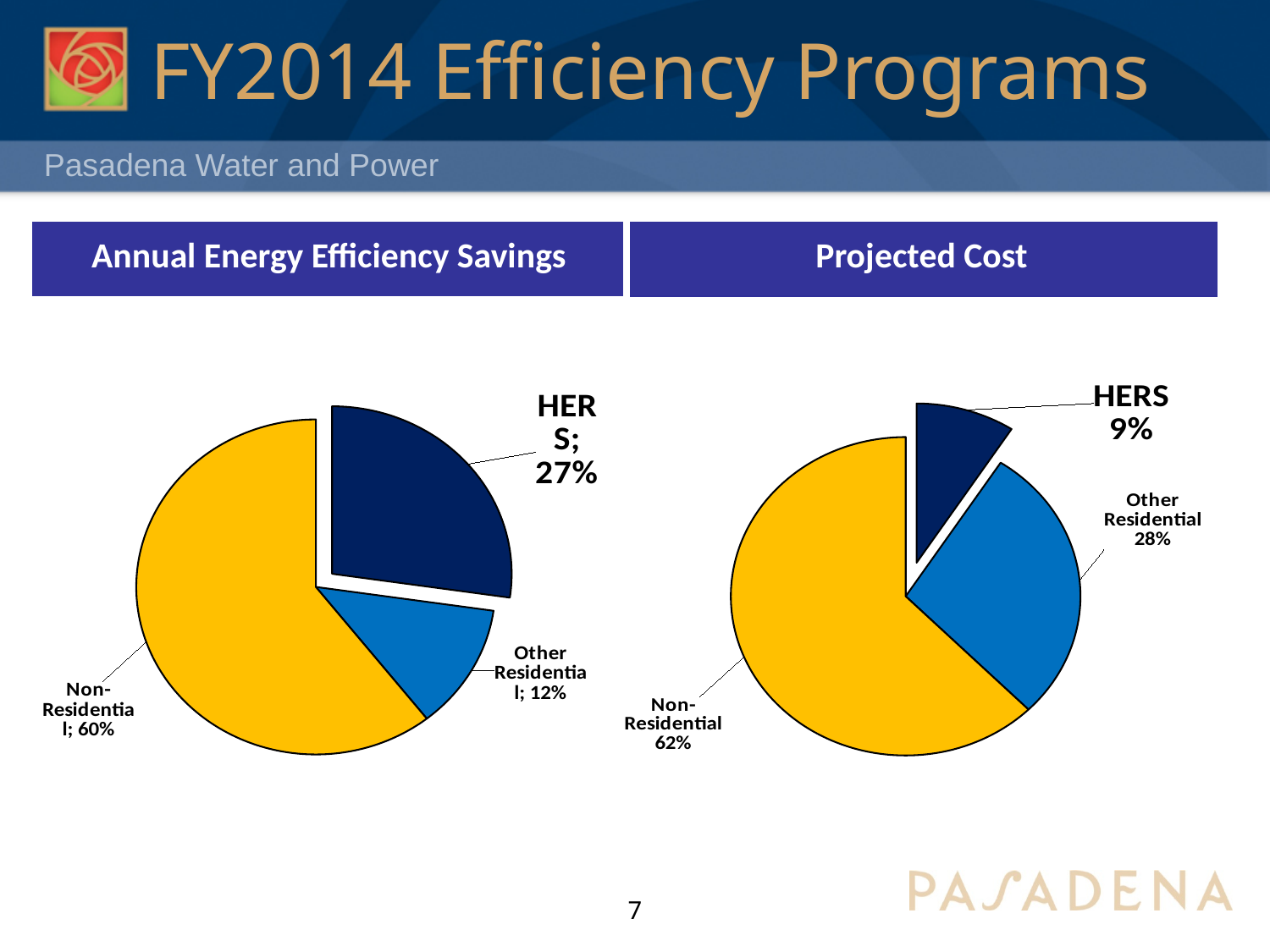
How many slices does the Projected Cost pie chart have? 3 In the Annual Energy Efficiency Savings chart, which category has the largest share? Non-Residential In the Projected Cost chart, what share is Non-Residential? 62% Which is larger: the HERS share in the Annual Energy Efficiency Savings chart or the HERS share in the Projected Cost chart? Annual Energy Efficiency Savings In the Projected Cost chart, what share of cost is HERS? 9% In the Annual Energy Efficiency Savings chart, what is the difference in percentage points between the HERS and Other Residential shares? 15 In the Annual Energy Efficiency Savings chart, what share is Non-Residential? 60% In the Annual Energy Efficiency Savings chart, what share of savings comes from HERS? 27% In the Annual Energy Efficiency Savings chart, what share is Other Residential? 12% What type of chart is used for Annual Energy Efficiency Savings? Pie chart In the Projected Cost chart, what share is Other Residential? 28% In the Projected Cost chart, which category has the smallest share? HERS